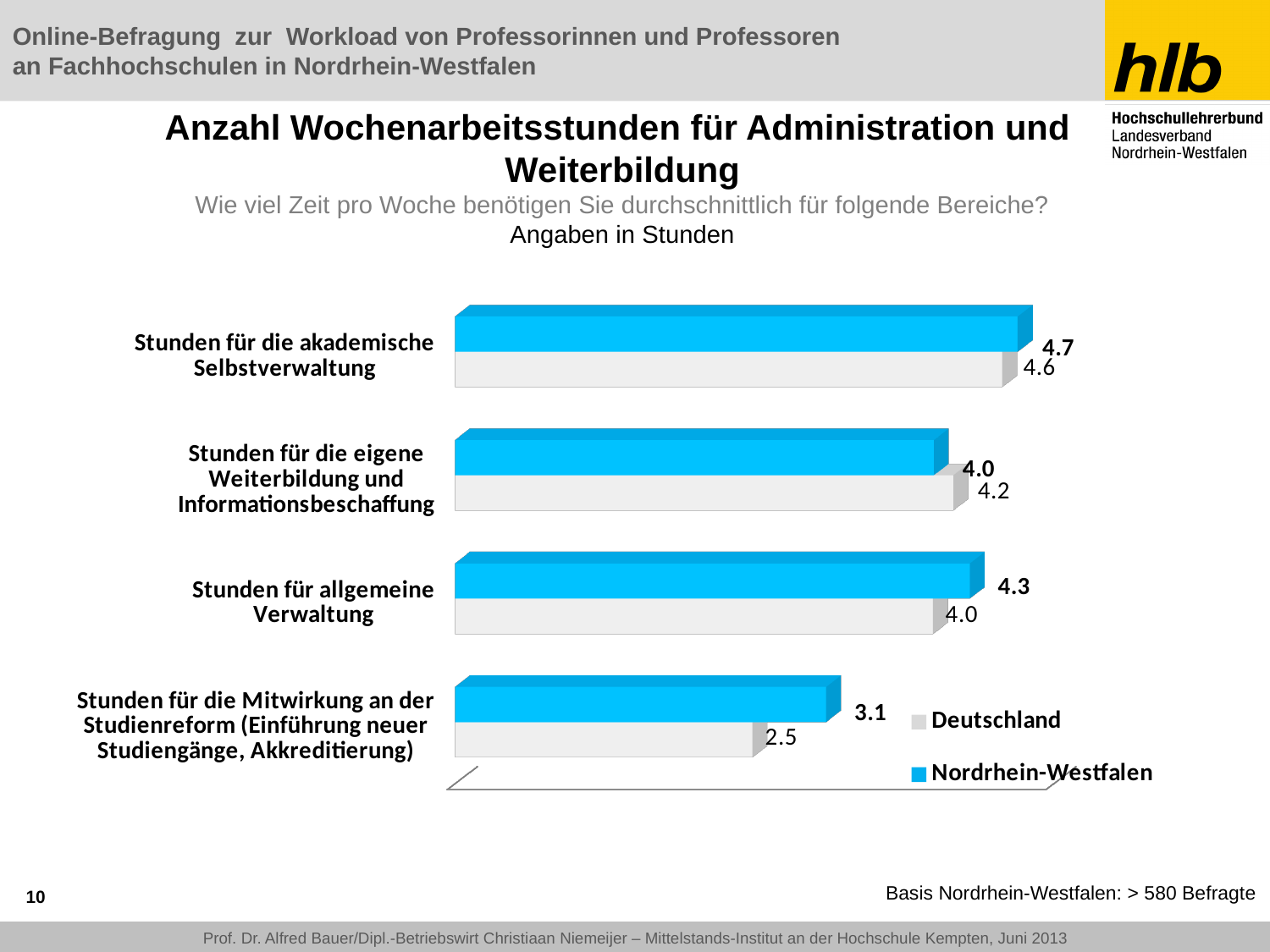
What is the Nordrhein-Westfalen value for "Stunden für die akademische Selbstverwaltung"? 4.7 What is the Deutschland value for "Stunden für die eigene Weiterbildung und Informationsbeschaffung"? 4.2 What kind of chart is shown on the slide? Bar chart How many categories are shown in the chart? 4 For "Stunden für die eigene Weiterbildung und Informationsbeschaffung", which series has the larger value, Deutschland or Nordrhein-Westfalen? Deutschland Which category has the lowest Deutschland value? Stunden für die Mitwirkung an der Studienreform (Einführung neuer Studiengänge, Akkreditierung) How many series does the legend list? 2 Which colour represents the Nordrhein-Westfalen series in the chart? Blue What is the Nordrhein-Westfalen value for "Stunden für allgemeine Verwaltung"? 4.3 What is the difference between the Nordrhein-Westfalen and Deutschland values for "Stunden für die Mitwirkung an der Studienreform"? 0.6 What is the Deutschland value for "Stunden für die Mitwirkung an der Studienreform (Einführung neuer Studiengänge, Akkreditierung)"? 2.5 Which category has the highest Nordrhein-Westfalen value? Stunden für die akademische Selbstverwaltung